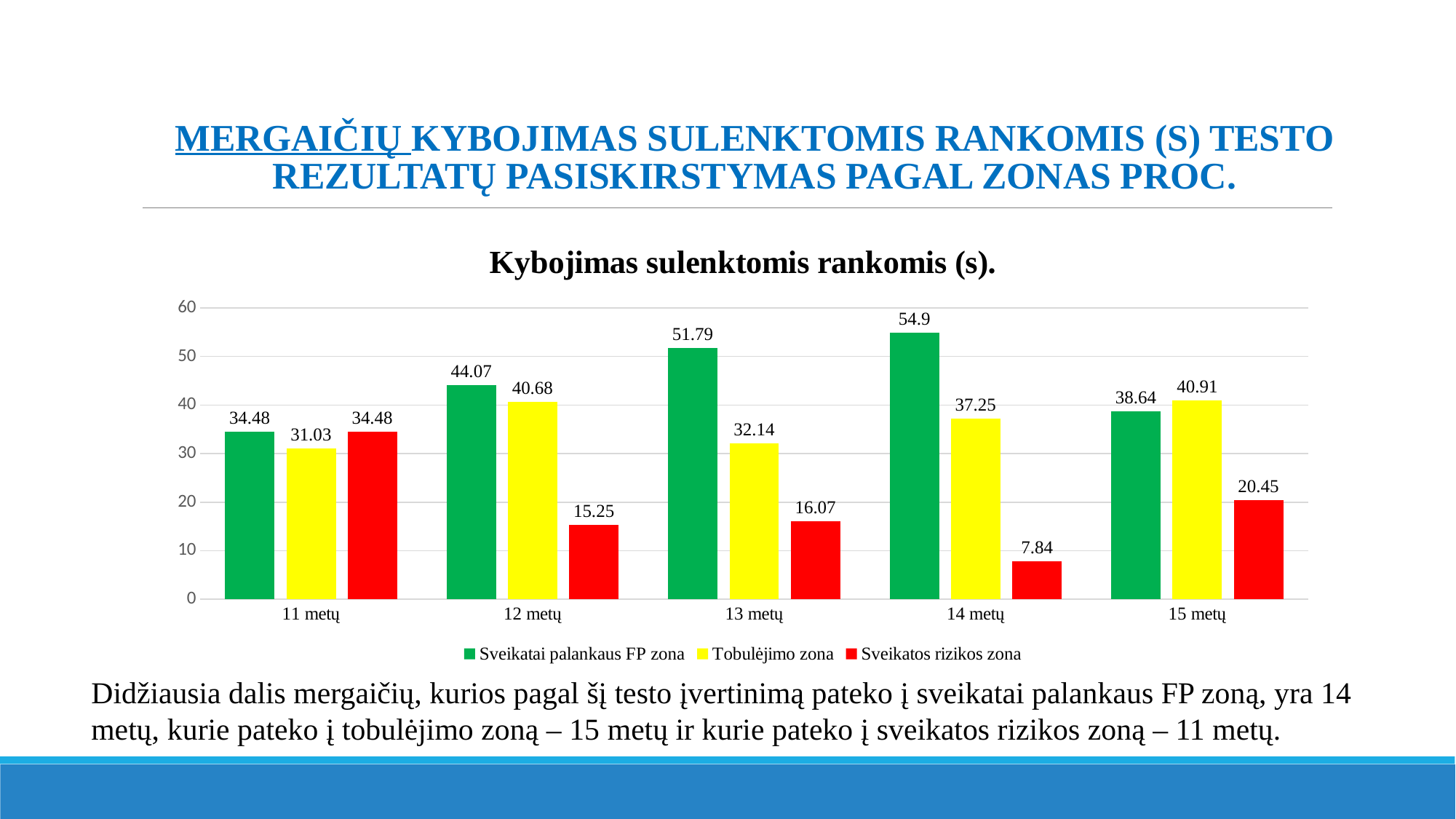
What kind of chart is shown? Bar chart Which is larger at 15 metų: Sveikatai palankaus FP zona or Tobulėjimo zona? Tobulėjimo zona Which age group has the highest value for Sveikatai palankaus FP zona? 14 metų How many age groups are shown on the x axis? 5 Which age group has the highest value for Tobulėjimo zona? 15 metų What colour represents Sveikatos rizikos zona? Red What is the value for Tobulėjimo zona at 12 metų? 40.68 Which age group has the lowest value for Sveikatos rizikos zona? 14 metų How many series does the legend list? 3 What is the difference between Sveikatai palankaus FP zona and Sveikatos rizikos zona at 14 metų? 47.06 What is the value for Sveikatos rizikos zona at 14 metų? 7.84 What is the value for Sveikatai palankaus FP zona at 13 metų? 51.79